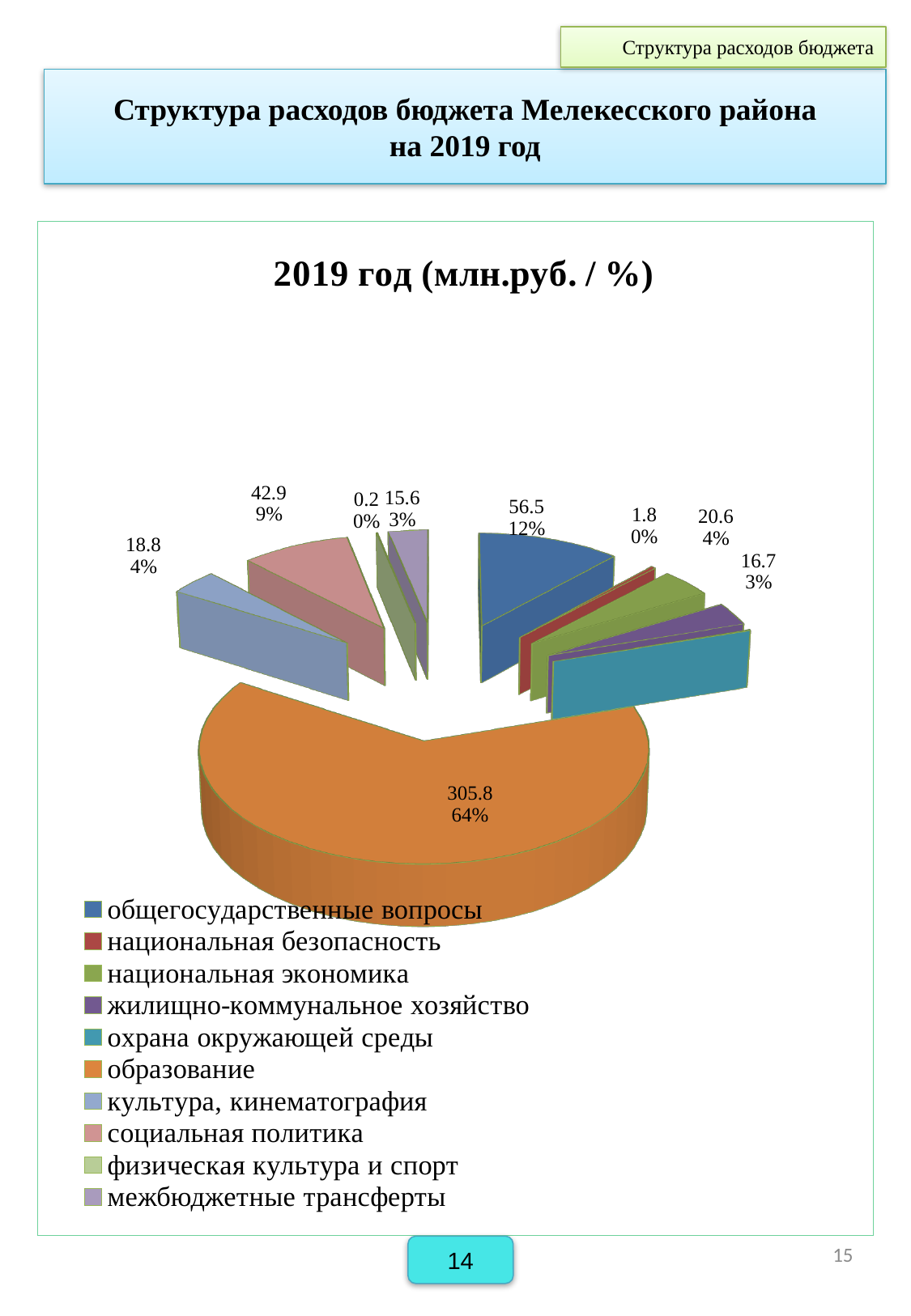
How many categories does the chart legend list? 10 What value in million rubles is shown for образование? 305.8 What share of the pie does образование take? 64% What percentage is shown for межбюджетные трансферты? 3% What value is shown for физическая культура и спорт? 0.2 What kind of chart is shown on the slide? pie chart Which is larger, the value for социальная политика or the value for культура, кинематография? социальная политика Which category has the largest slice of the pie? образование What percentage is shown for социальная политика? 9% What value is shown for общегосударственные вопросы? 56.5 What is the title of the chart? 2019 год (млн.руб. / %) What is the difference between the values for общегосударственные вопросы (56.5) and национальная экономика (20.6)? 35.9